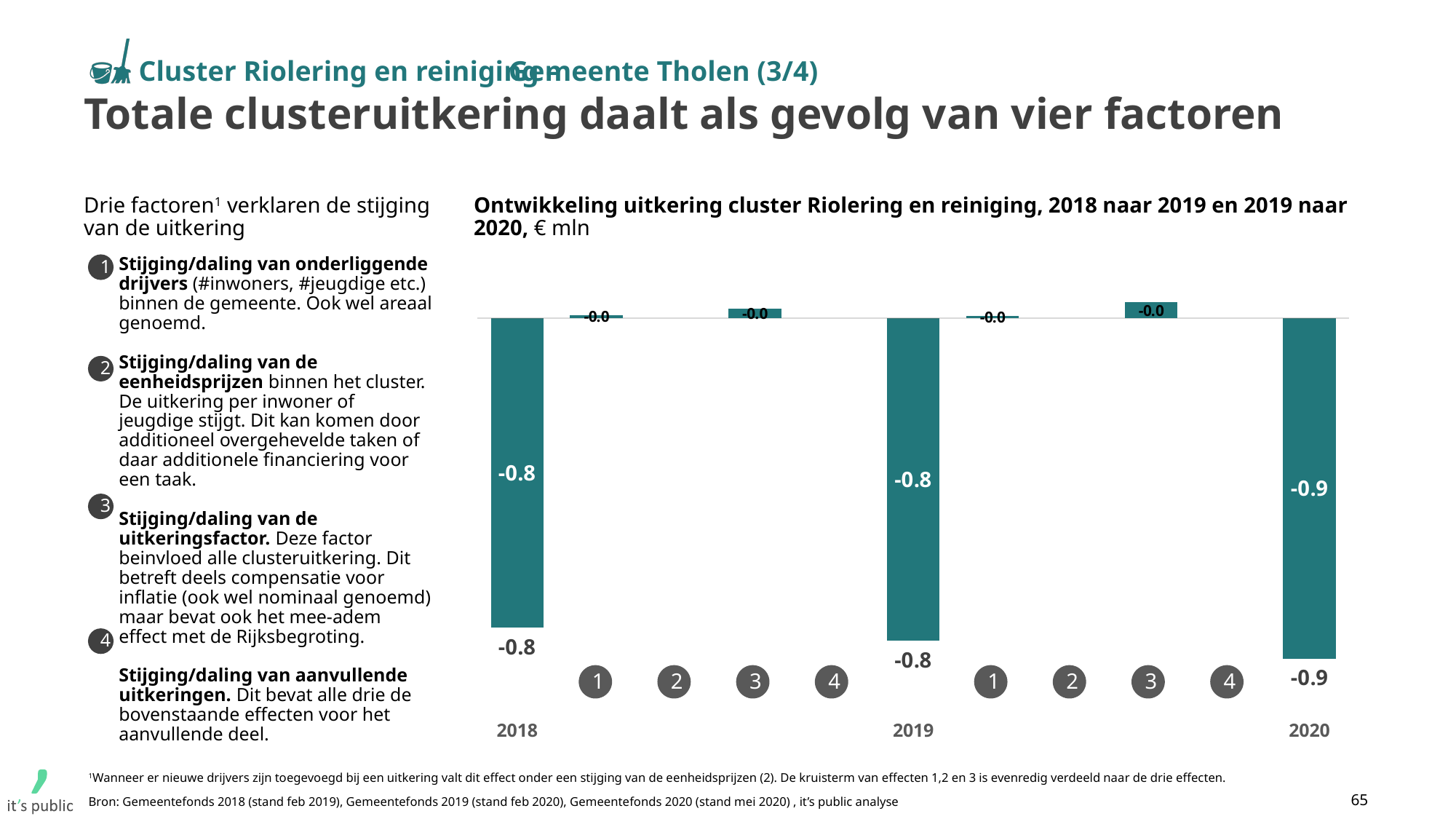
What is the difference between the uitkering values for 2018 and 2020? 0.1 What value is labelled on factor 3 between 2019 and 2020? -0.0 Does the uitkering value rise or fall from 2018 to 2020? Fall What kind of chart is shown on the slide? Bar chart What is the value of the uitkering for 2020 in the chart? -0.9 Which year has the lowest uitkering value in the chart? 2020 Which is larger, the uitkering value for 2018 or for 2020? 2018 What is the value of the uitkering for 2019 in the chart? -0.8 How many factor bars are shown between 2018 and 2019? 4 How many year totals (2018, 2019, 2020) are shown in the chart? 3 What is the value of the uitkering for 2018 in the chart? -0.8 In what unit are the values in the chart expressed? € mln